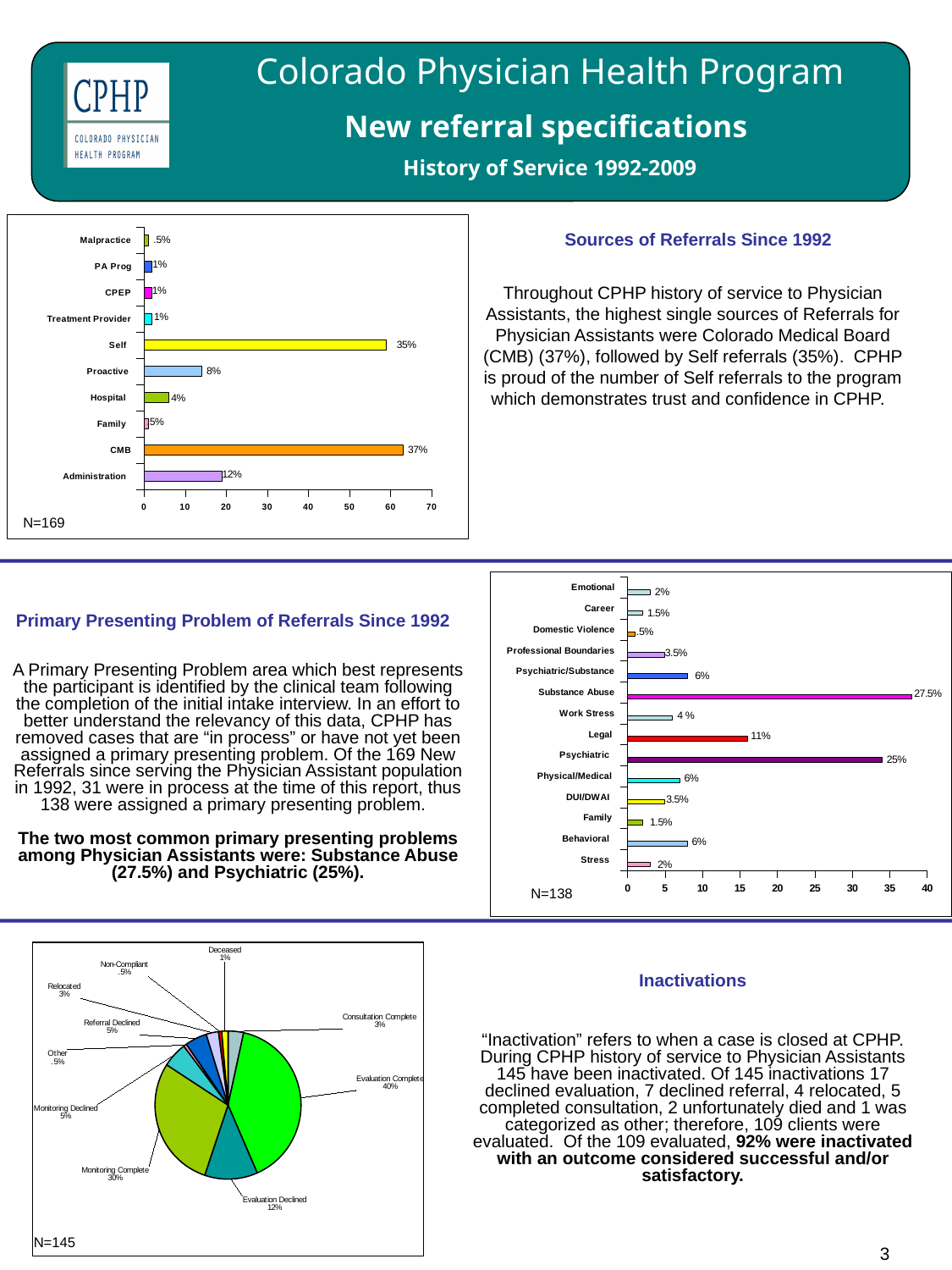
How many categories are shown in the top-left bar chart of sources of referrals? 10 What kind of chart is the top-left chart of sources of referrals? Bar chart In the top-left bar chart of sources of referrals, which category has the highest value? CMB In the middle-right bar chart of primary presenting problems, which category has the lowest value? Domestic Violence How many categories are shown in the middle-right bar chart of primary presenting problems? 14 In the bottom-left pie chart of inactivations, what share does Monitoring Complete have? 30% In the top-left bar chart of sources of referrals, what is the value for CMB? 37% In the middle-right bar chart of primary presenting problems, what is the value for Legal? 11% In the bottom-left pie chart of inactivations, which slice is the largest? Evaluation Complete In the middle-right bar chart of primary presenting problems, which category has the highest value? Substance Abuse In the middle-right bar chart of primary presenting problems, which is larger, Psychiatric or Substance Abuse? Substance Abuse In the top-left bar chart of sources of referrals, what is the difference between the values for CMB and Self? 2%